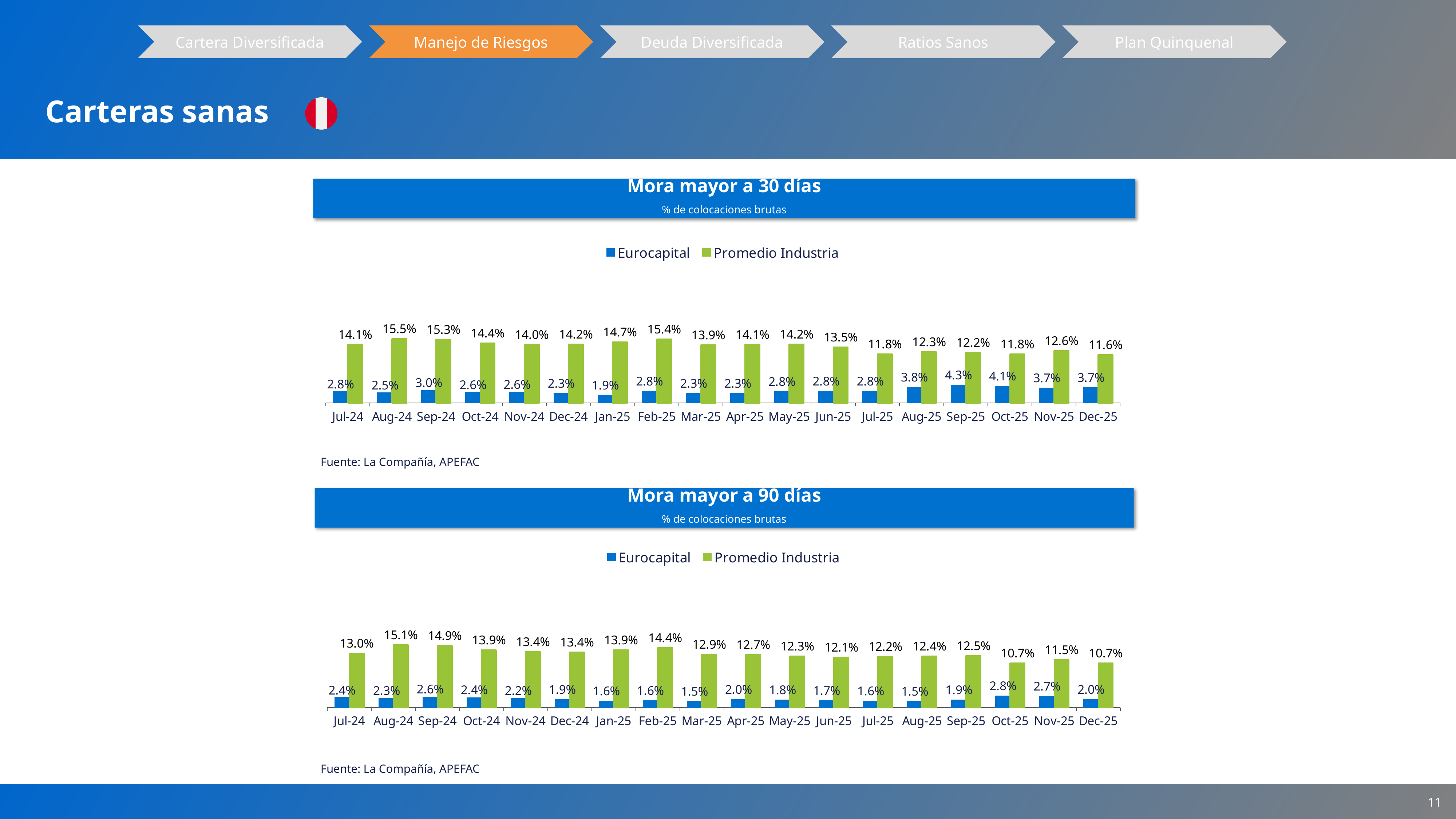
In the 'Mora mayor a 90 días' chart, what is the Promedio Industria value for Nov-25? 11.5% In the 'Mora mayor a 30 días' chart, what is the Promedio Industria value for Feb-25? 15.4% In the 'Mora mayor a 90 días' chart, what is the difference between the Promedio Industria and Eurocapital values for Dec-25? 8.7 percentage points In the 'Mora mayor a 30 días' chart, what is the Eurocapital value for Sep-25? 4.3% In the 'Mora mayor a 30 días' chart, what is the difference between the Promedio Industria and Eurocapital values for Aug-24? 13.0 percentage points In the 'Mora mayor a 90 días' chart, which month has the highest Eurocapital value? Oct-25 In the 'Mora mayor a 30 días' chart, which month has the lowest Eurocapital value? Jan-25 In the 'Mora mayor a 90 días' chart, which is larger for Jan-25: the Eurocapital value or the Promedio Industria value? Promedio Industria In the 'Mora mayor a 90 días' chart, what is the Eurocapital value for Oct-25? 2.8% How many months are shown on the x axis of the 'Mora mayor a 30 días' chart? 18 In the 'Mora mayor a 30 días' chart, which month has the highest Promedio Industria value? Aug-24 How many series does the legend of the 'Mora mayor a 90 días' chart list? 2